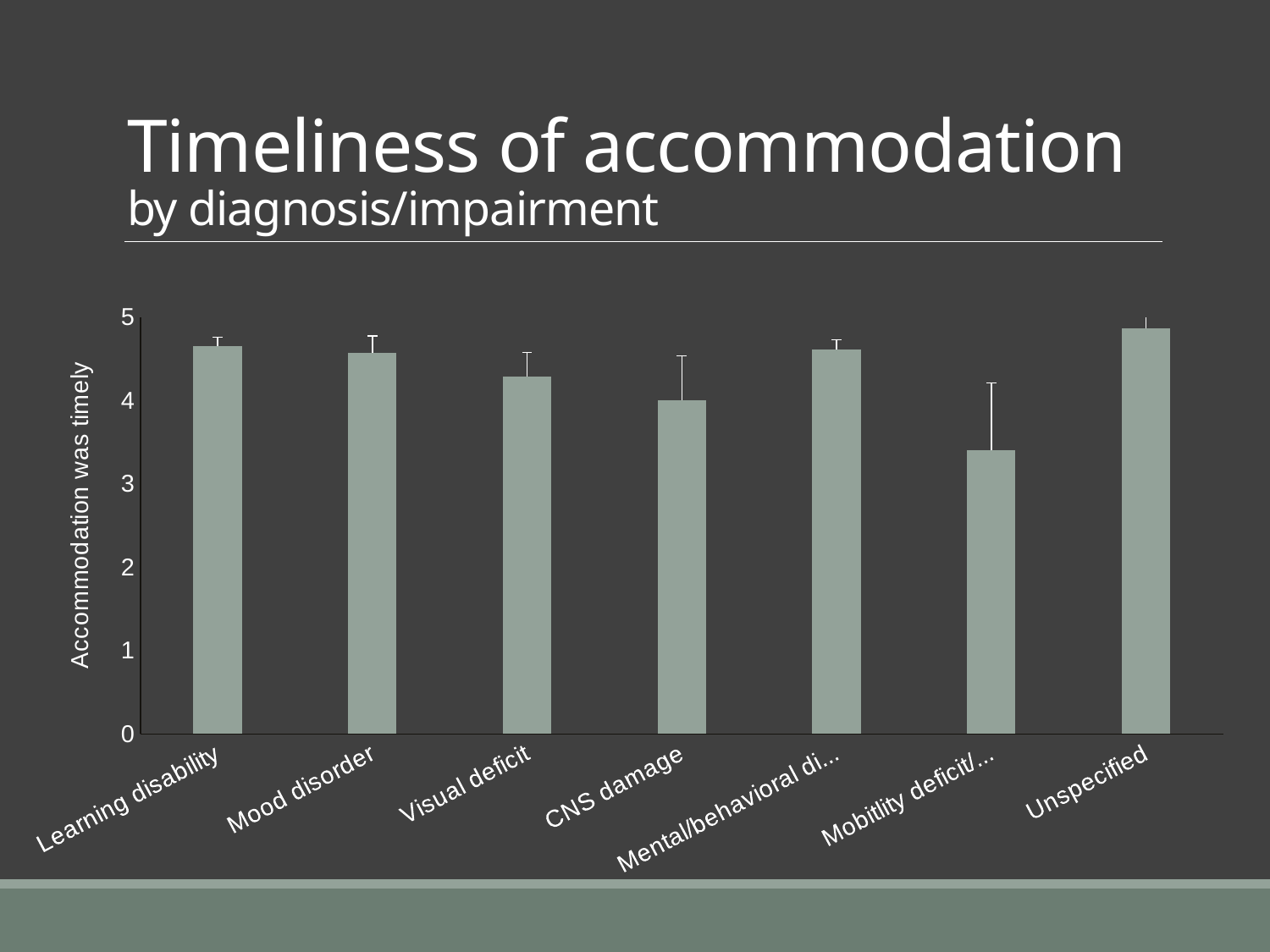
Is the value for Unspecified greater or less than 5? less How many diagnosis/impairment categories are plotted in the chart? 7 Which category has the lowest bar in the chart? Mobitlity deficit/... What is the label on the vertical axis of the chart? Accommodation was timely Is the value for Mobitlity deficit/... greater or less than 4? less What is the title of the slide containing the chart? Timeliness of accommodation by diagnosis/impairment Is the value for Learning disability greater or less than 4? greater Which category has the highest bar in the chart? Unspecified Which is larger, the value for Visual deficit or the value for Mobitlity deficit/...? Visual deficit What kind of chart is shown on the slide? bar chart Which is larger, the value for Learning disability or the value for CNS damage? Learning disability